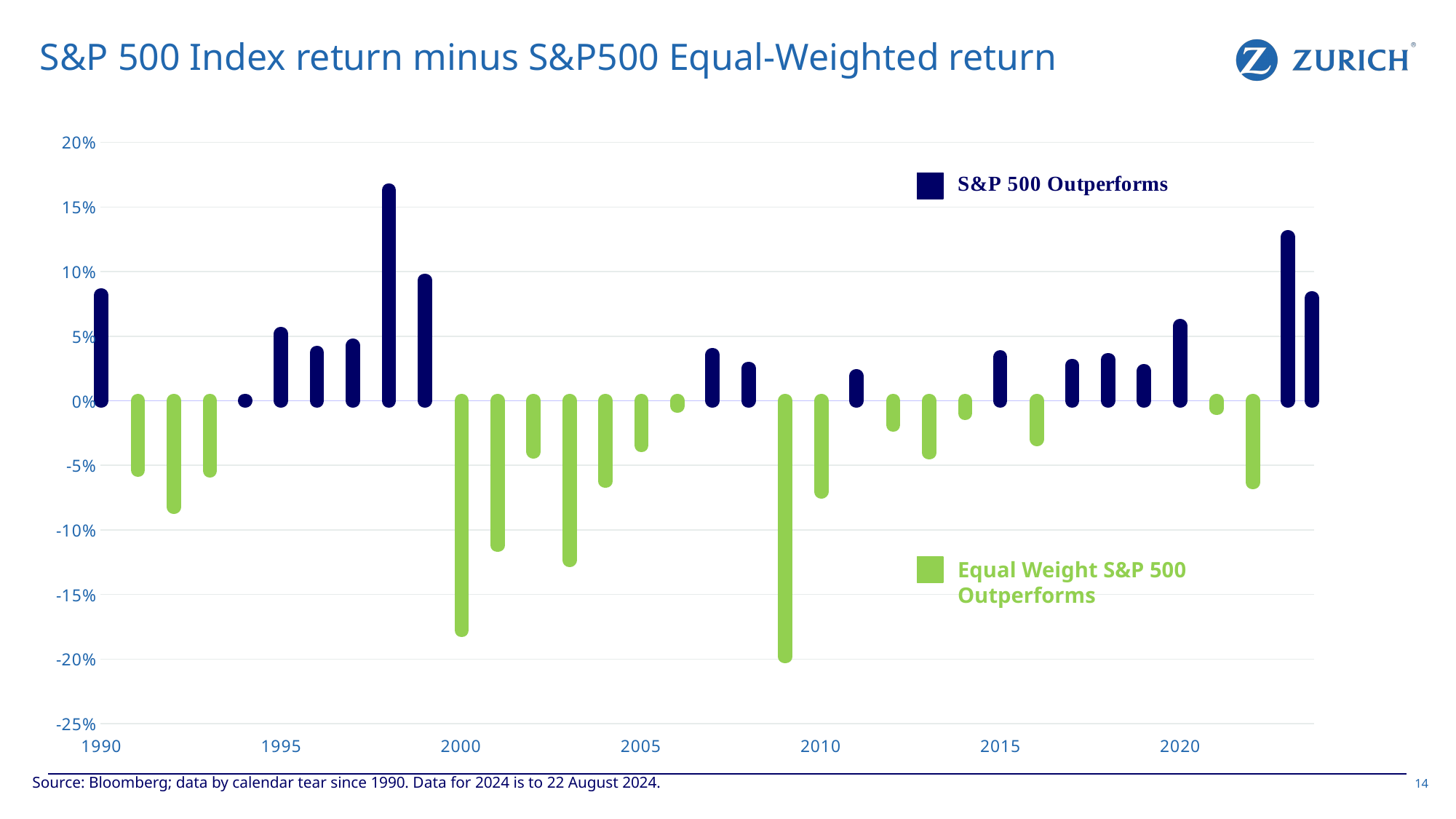
Is the value for 2000 greater or less than -15%? less Is the value for 1998 greater or less than 15%? greater Is the value for 2023 greater or less than 10%? greater What colour are the bars for years when the Equal Weight S&P 500 outperforms? Green Which year has the lower (more negative) value, 2000 or 2001? 2000 Which year has the larger value, 1998 or 2023? 1998 How many series does the legend list? 2 Which year has the lowest value (largest Equal Weight S&P 500 outperformance)? 2009 What kind of chart is shown on the slide? Bar chart Which year has the highest value (largest S&P 500 outperformance)? 1998